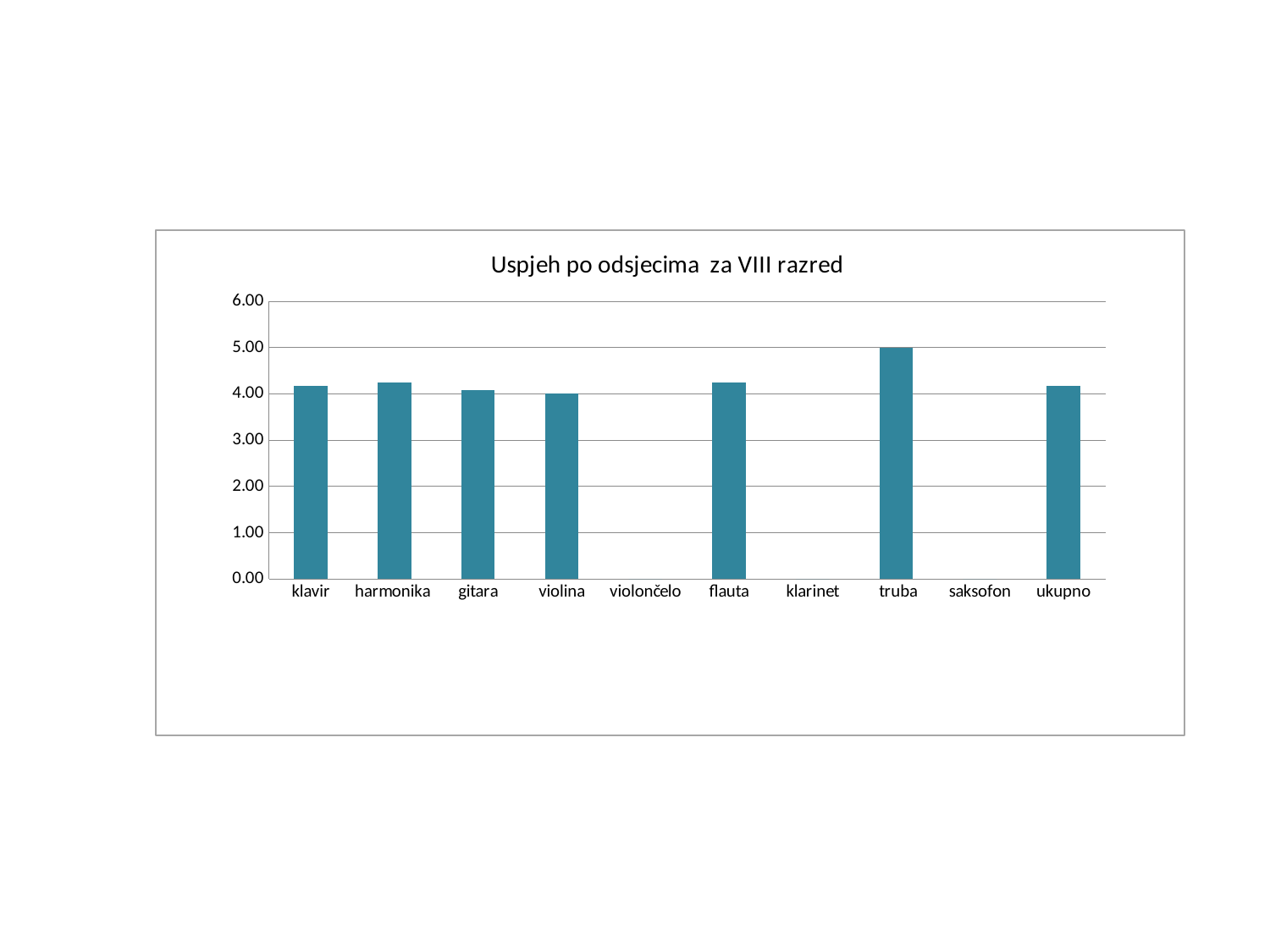
How many categories are shown on the x axis of the chart? 10 Is the value for harmonika greater or less than 5.00? less Which categories on the x axis have no bar shown? violončelo, klarinet, saksofon What kind of chart is shown on the slide? bar chart Which category has the highest bar in the chart? truba Which is larger, the value for harmonika or the value for gitara? harmonika What is the title of the chart? Uspjeh po odsjecima za VIII razred Is the value for gitara greater or less than 3.00? greater What is the value for truba? 5.00 Is the value for ukupno greater or less than 5.00? less Which is larger, the value for truba or the value for klavir? truba